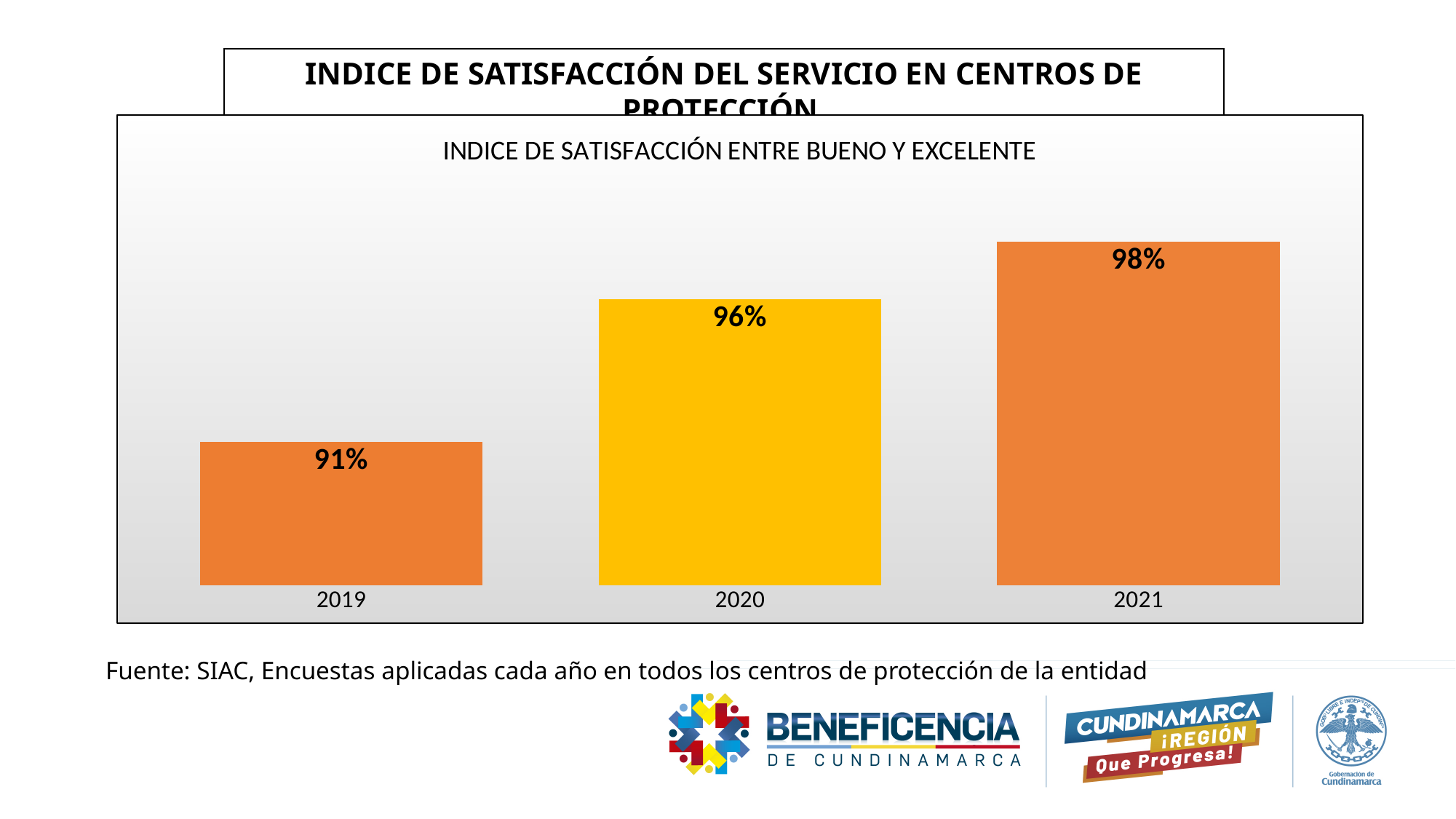
What is the satisfaction index value for 2021? 98% What is the satisfaction index value for 2019? 91% What kind of chart is shown on the slide? Bar chart Does the satisfaction index rise or fall from 2019 to 2021? Rise What is the difference between the satisfaction index in 2020 and in 2019? 5% Which year has the lowest satisfaction index? 2019 How many years are shown on the chart? 3 What is the satisfaction index value for 2020? 96% Which year has the highest satisfaction index? 2021 Which year has a higher satisfaction index, 2020 or 2021? 2021 What is the difference between the satisfaction index in 2021 and in 2019? 7% What is the title shown inside the chart area? INDICE DE SATISFACCIÓN ENTRE BUENO Y EXCELENTE